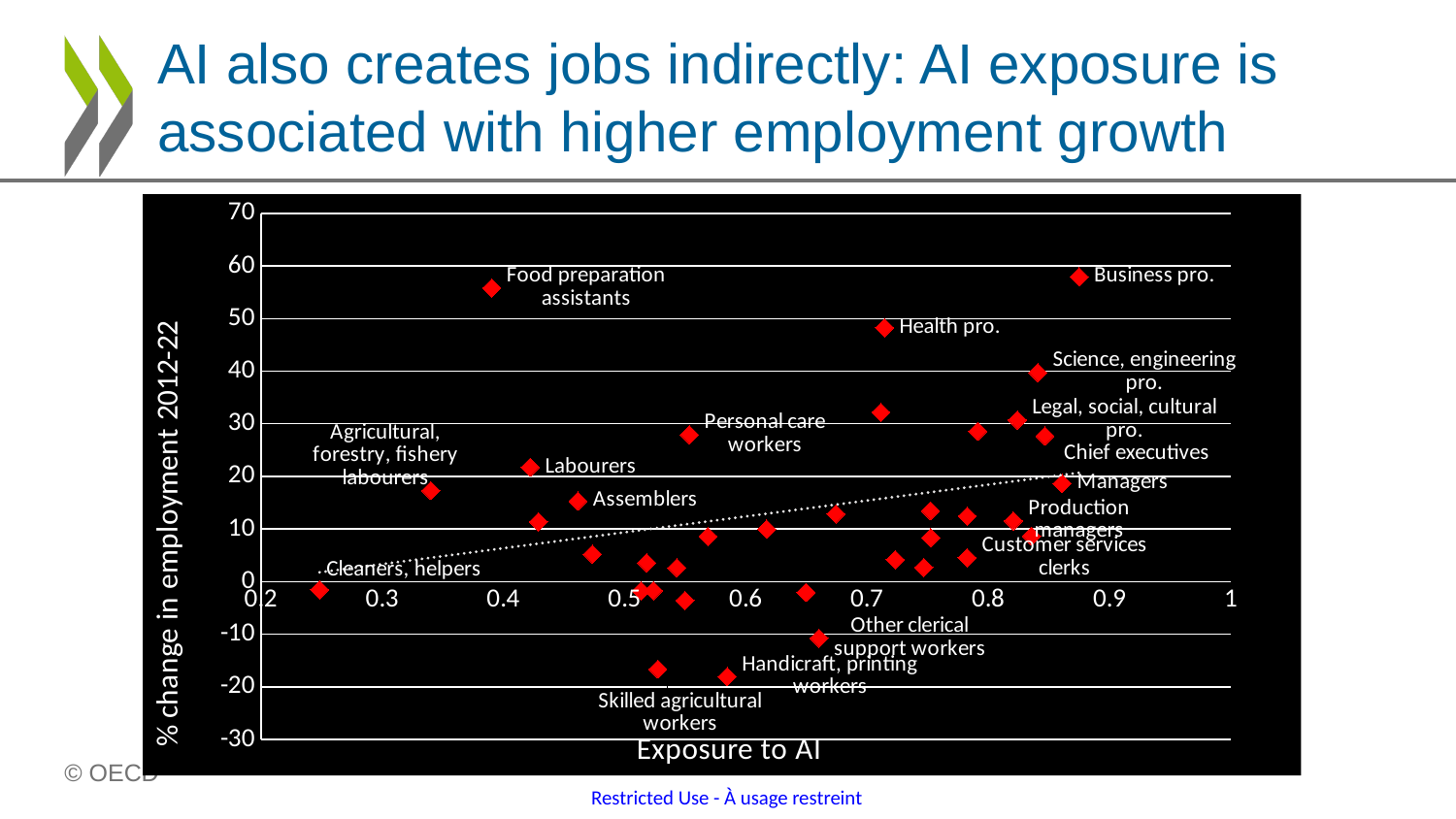
According to the dotted trend line, does the % change in employment rise or fall as exposure to AI increases? rise Is the % change in employment for Business pro. greater or less than 50? greater Which has the higher % change in employment, Health pro. or Science, engineering pro.? Health pro. What is the title of the x axis of the chart? Exposure to AI Is the % change in employment for Health pro. greater or less than 40? greater Is the exposure to AI for Cleaners, helpers greater or less than 0.3? less What kind of chart is shown on the slide? scatter chart What is the title of the y axis of the chart? % change in employment 2012-22 Which has the higher % change in employment, Labourers or Assemblers? Labourers